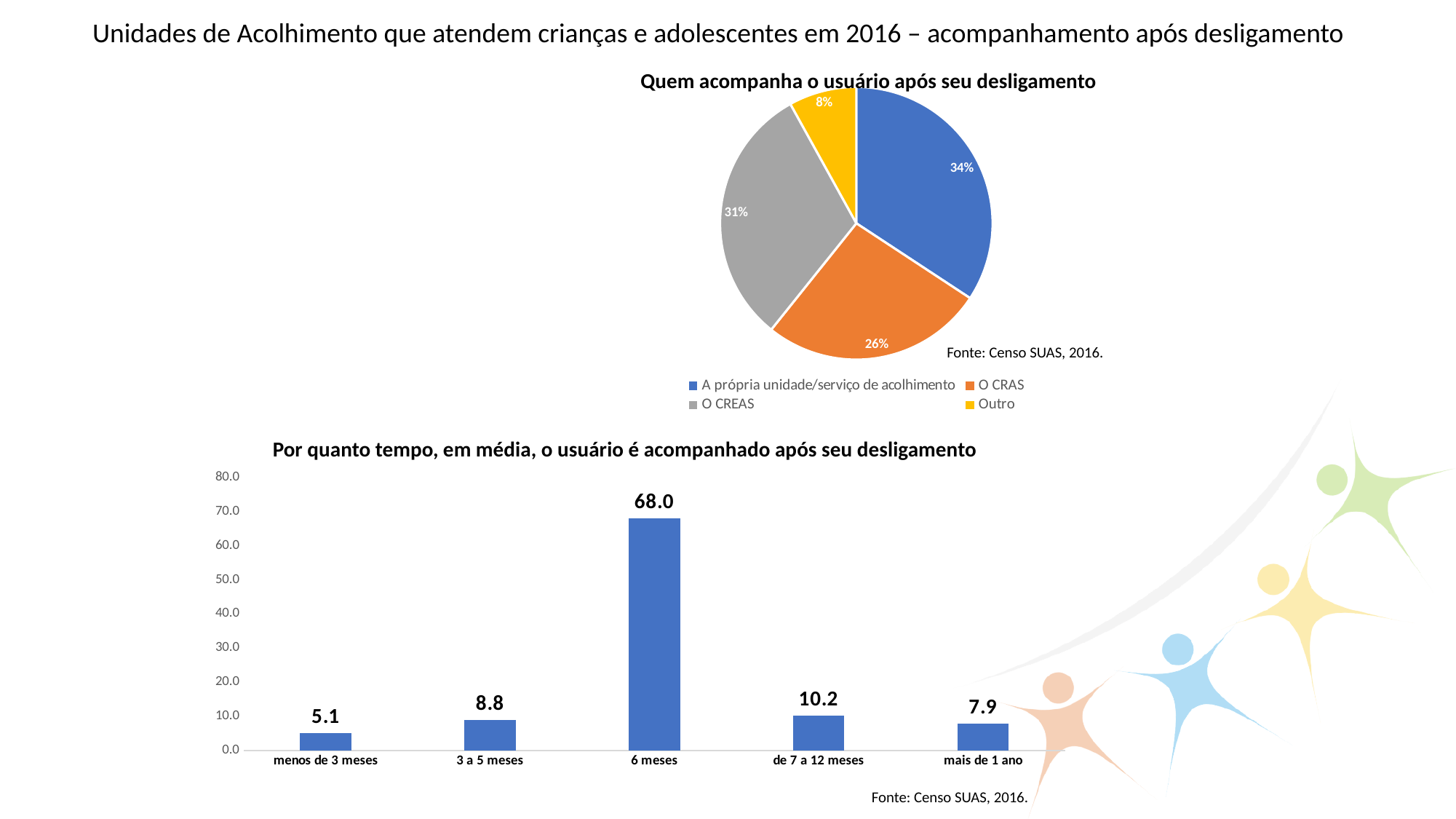
In the pie chart 'Quem acompanha o usuário após seu desligamento', what is the difference in percentage points between 'O CRAS' and 'Outro'? 18 In the bar chart 'Por quanto tempo, em média, o usuário é acompanhado após seu desligamento', which is larger: 'de 7 a 12 meses' or 'mais de 1 ano'? de 7 a 12 meses In the pie chart 'Quem acompanha o usuário após seu desligamento', which category has the smallest slice? Outro In the pie chart 'Quem acompanha o usuário após seu desligamento', how many categories does the legend list? 4 In the bar chart 'Por quanto tempo, em média, o usuário é acompanhado após seu desligamento', what is the value for '6 meses'? 68.0 In the pie chart 'Quem acompanha o usuário após seu desligamento', what share is labelled for 'A própria unidade/serviço de acolhimento'? 34% In the bar chart 'Por quanto tempo, em média, o usuário é acompanhado após seu desligamento', what is the difference between '6 meses' and '3 a 5 meses'? 59.2 In the bar chart 'Por quanto tempo, em média, o usuário é acompanhado após seu desligamento', which category has the lowest value? menos de 3 meses In the pie chart 'Quem acompanha o usuário após seu desligamento', what share is labelled for 'O CREAS'? 31% In the bar chart 'Por quanto tempo, em média, o usuário é acompanhado após seu desligamento', what is the value for 'menos de 3 meses'? 5.1 In the pie chart 'Quem acompanha o usuário após seu desligamento', which category has the largest slice? A própria unidade/serviço de acolhimento What kind of chart is the lower chart on the slide, 'Por quanto tempo, em média, o usuário é acompanhado após seu desligamento'? Bar chart